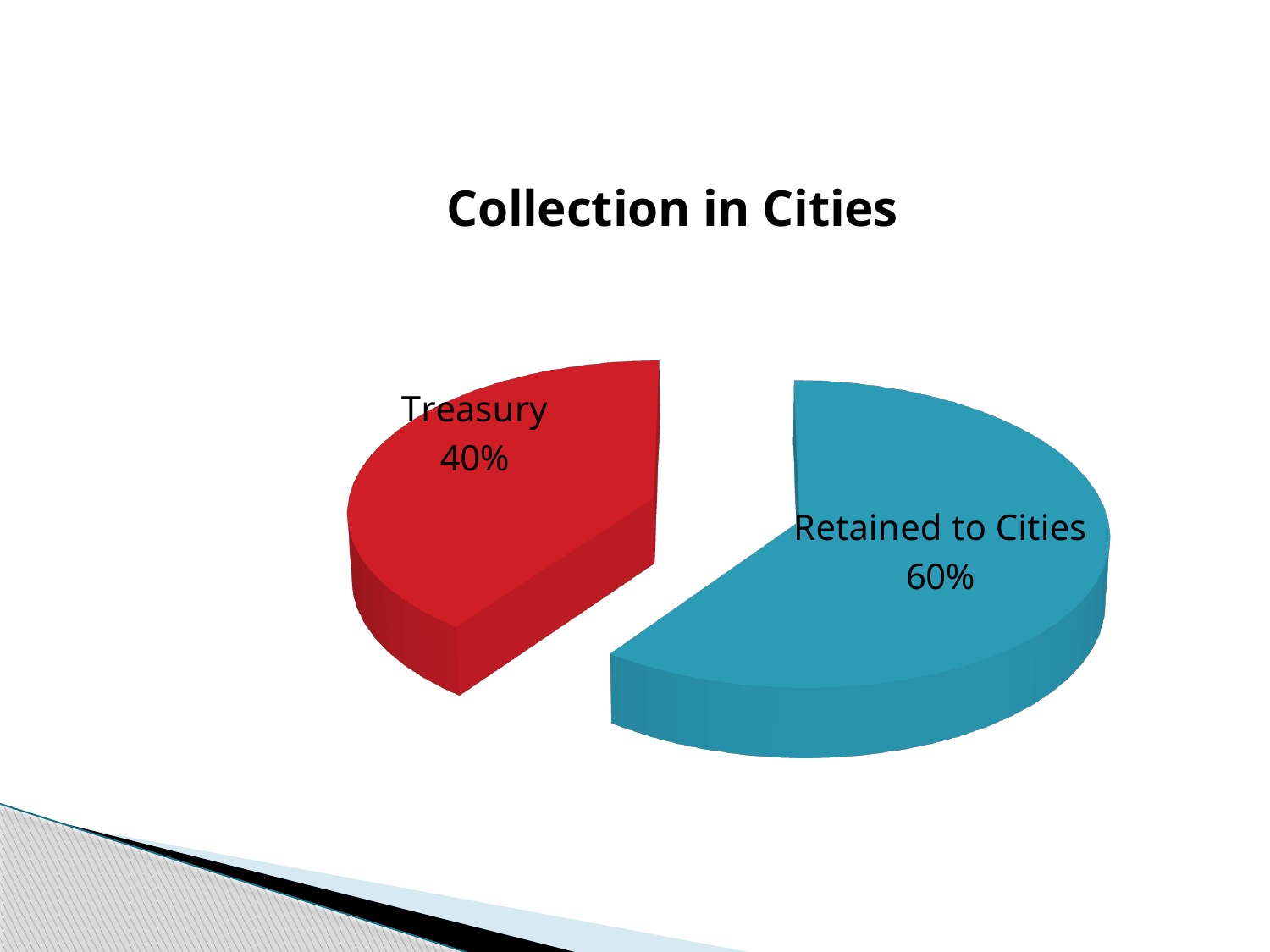
Which is larger, the Treasury slice or the Retained to Cities slice? Retained to Cities What kind of chart is shown on the slide? pie chart What is the difference in percentage points between Retained to Cities and Treasury? 20% Which slice is the smallest? Treasury How many slices does the pie chart have? 2 What share of the pie is labelled Retained to Cities? 60% What is the title of the chart? Collection in Cities What colour is the Treasury slice? red Is the share for Treasury greater or less than 50%? less Which slice is the largest? Retained to Cities What share of the pie is labelled Treasury? 40%